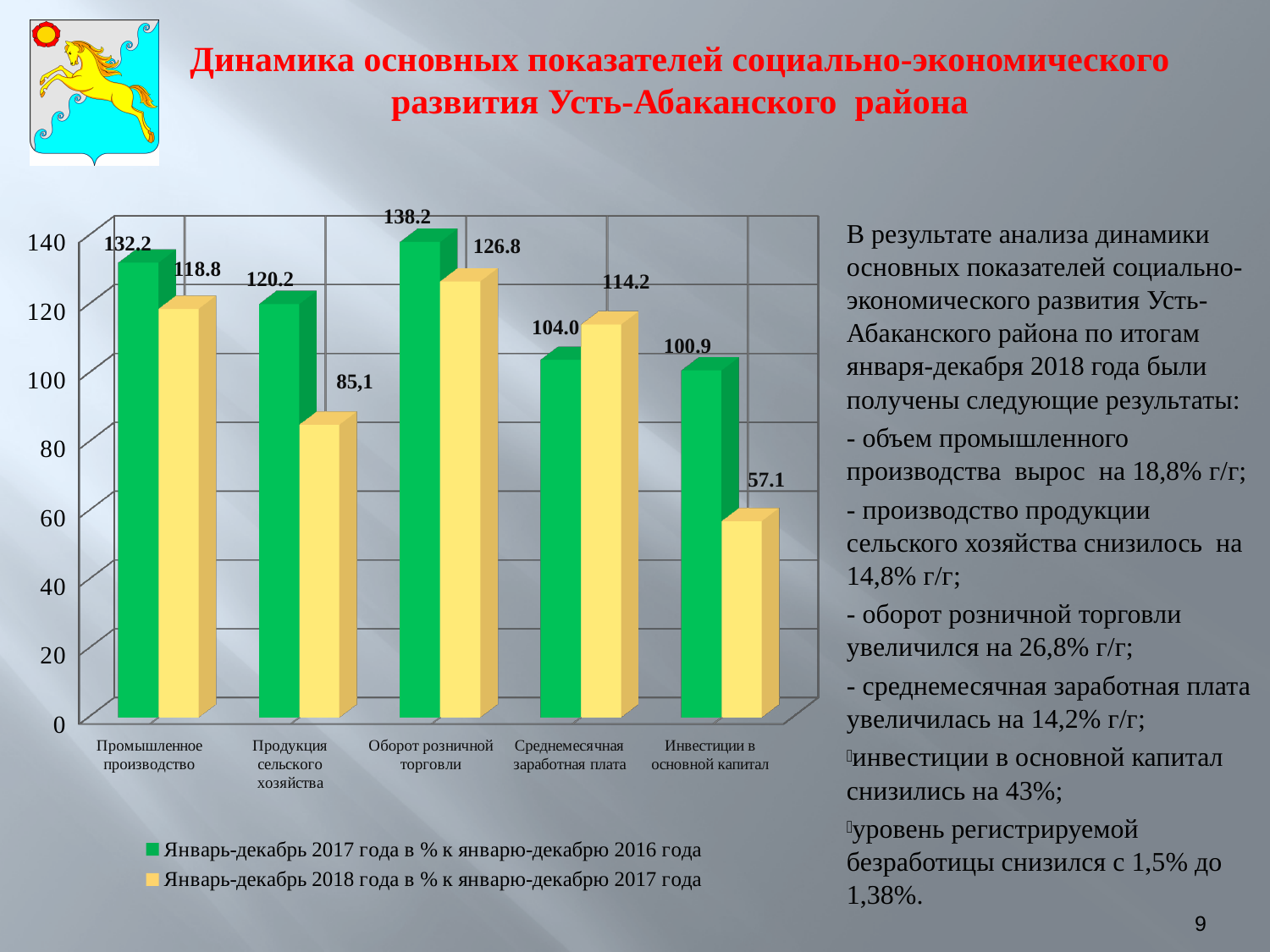
What kind of chart is shown on the slide? bar chart Is the value for Инвестиции в основной капитал in the 2018 series greater or less than 60? less What is the value for Промышленное производство in the series 'Январь-декабрь 2017 года в % к январю-декабрю 2016 года'? 132.2 How many series does the chart legend list? 2 Which category has the lowest value in the series 'Январь-декабрь 2018 года в % к январю-декабрю 2017 года'? Инвестиции в основной капитал What is the value for Инвестиции в основной капитал in the series 'Январь-декабрь 2018 года в % к январю-декабрю 2017 года'? 57.1 What is the difference between the two series values for Оборот розничной торговли? 11.4 How many categories are shown on the x axis of the chart? 5 What is the value for Продукция сельского хозяйства in the series 'Январь-декабрь 2018 года в % к январю-декабрю 2017 года'? 85,1 For Среднемесячная заработная плата, which series has the larger value? Январь-декабрь 2018 года в % к январю-декабрю 2017 года What colour represents the series 'Январь-декабрь 2018 года в % к январю-декабрю 2017 года'? yellow Which category has the highest value in the series 'Январь-декабрь 2017 года в % к январю-декабрю 2016 года'? Оборот розничной торговли